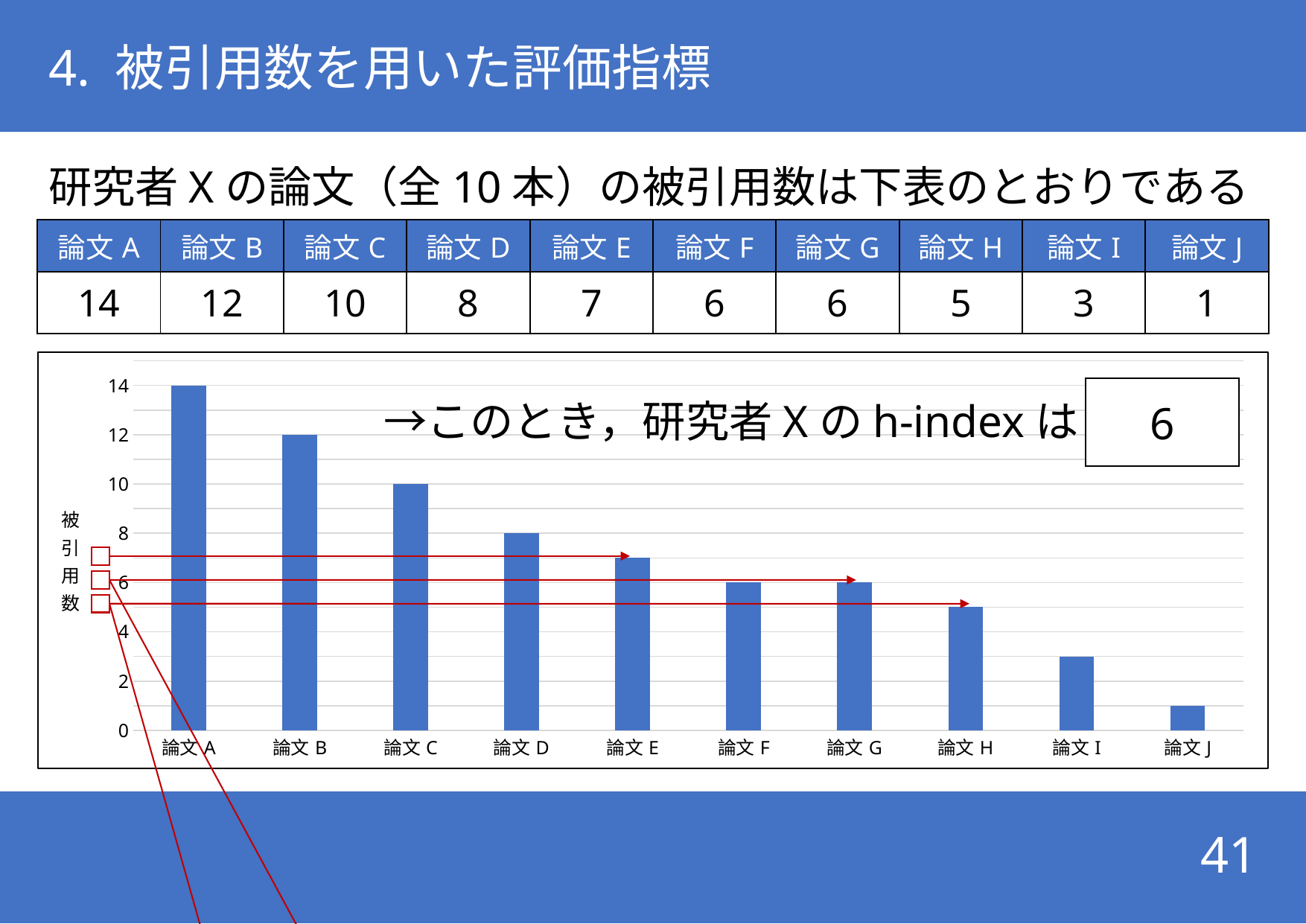
Is the value for 論文 I greater or less than 4? less What is the citation count for 論文 H? 5 Which has more citations, 論文 B or 論文 D? 論文 B How many papers (categories) are plotted on the x axis of the chart? 10 Which paper has the lowest citation count? 論文 J What is the citation count for 論文 E? 7 Do the citation counts rise or fall from 論文 A to 論文 J along the x axis? fall What is the label on the vertical axis of the chart? 被引用数 What type of chart is shown on the slide? bar chart What is the difference in citation count between 論文 A and 論文 C? 4 What is the citation count (被引用数) for 論文 A? 14 Which paper has the highest citation count? 論文 A